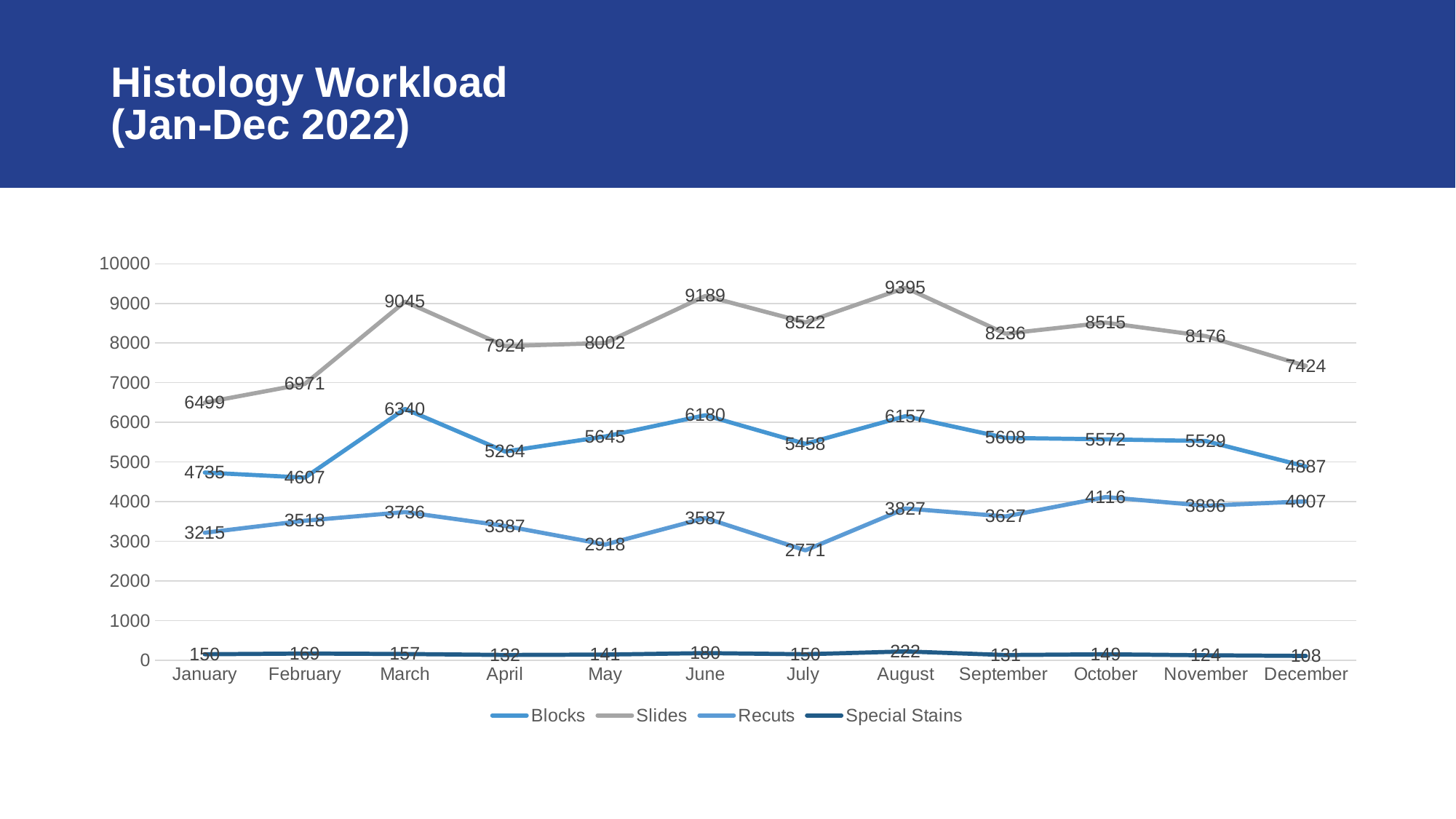
What is the value for Slides in August? 9395 Which is larger, the Blocks value in June or the Blocks value in August? June In which month is the Recuts value lowest? July How many series does the legend list? 4 How many months are plotted on the x axis? 12 In which month is the Slides value highest? August What is the difference between the Slides value in March and the Slides value in April? 1121 What is the value for Recuts in July? 2771 What is the value for Special Stains in December? 108 What kind of chart is shown on the slide? Line chart What is the title of the slide? Histology Workload (Jan-Dec 2022) What is the value for Blocks in March? 6340